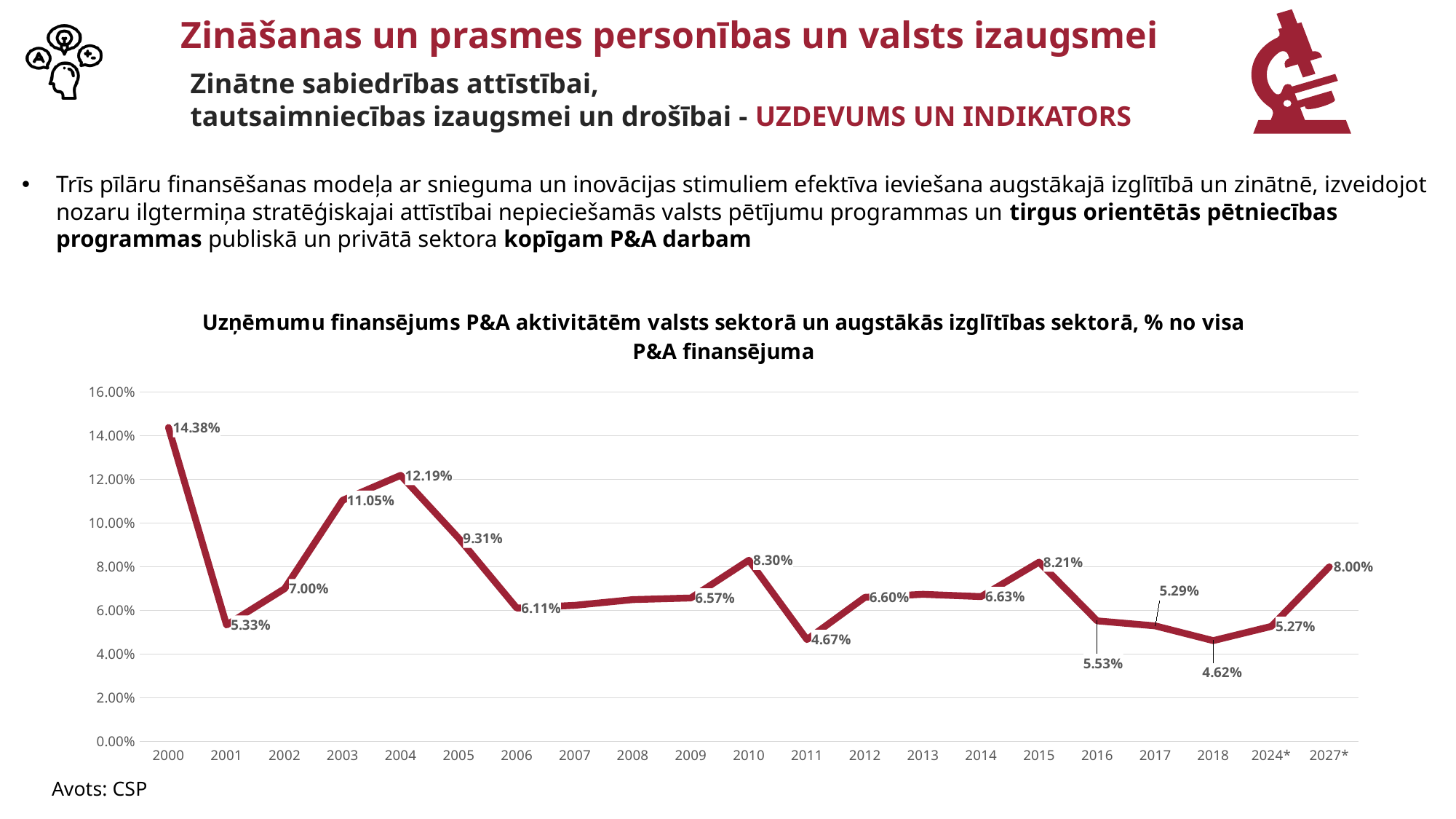
How many data points are plotted on the chart? 21 Which year has the highest value? 2000 What is the value for 2011? 4.67% Is the value for 2013 greater or less than 8.00%? less What is the value for 2027*? 8.00% Which year has the lowest value? 2018 What is the difference between the values for 2004 and 2003? 1.14% What is the value for 2000? 14.38% What is the value for 2004? 12.19% Does the value rise or fall from 2000 to 2001? fall What kind of chart is shown? line chart Which is larger, the value for 2010 or the value for 2015? 2010